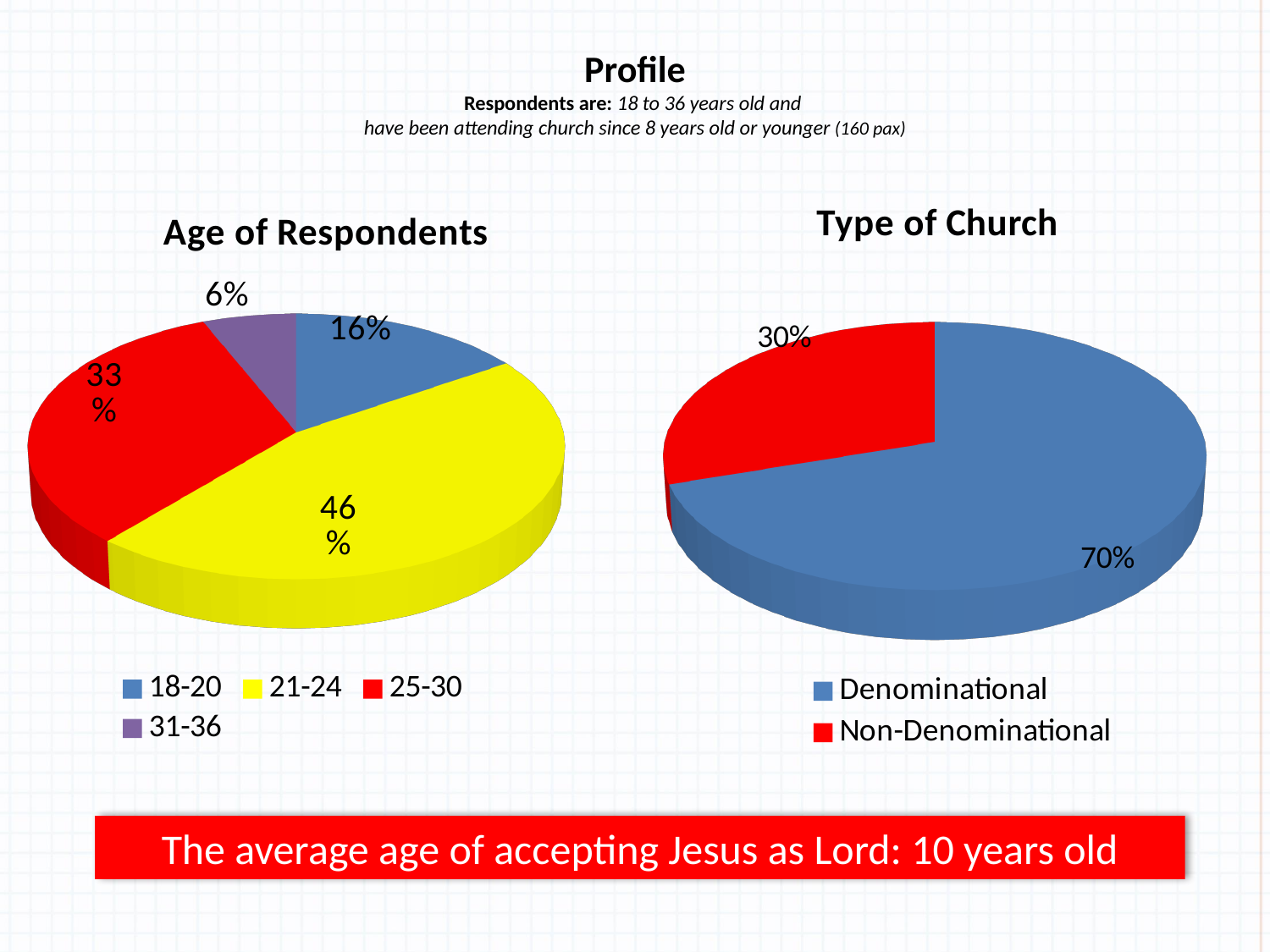
In the 'Type of Church' chart, what share of respondents attend a Denominational church? 70% In the 'Age of Respondents' chart, which group has a larger share, 18-20 or 25-30? 25-30 In the 'Age of Respondents' chart, which age group has the smallest share? 31-36 In the 'Age of Respondents' chart, what share of respondents are aged 21-24? 46% In the 'Age of Respondents' chart, which age group has the largest share? 21-24 In the 'Type of Church' chart, what share of respondents attend a Non-Denominational church? 30% In the 'Age of Respondents' chart, what is the difference in percentage points between the 25-30 and 18-20 groups? 17 What kind of chart is the 'Type of Church' chart? Pie chart In the 'Type of Church' chart, what is the difference in percentage points between Denominational and Non-Denominational? 40 In the 'Type of Church' chart, which colour represents Non-Denominational? Red How many age groups are shown in the 'Age of Respondents' chart? 4 In the 'Age of Respondents' chart, what share of respondents are aged 31-36? 6%